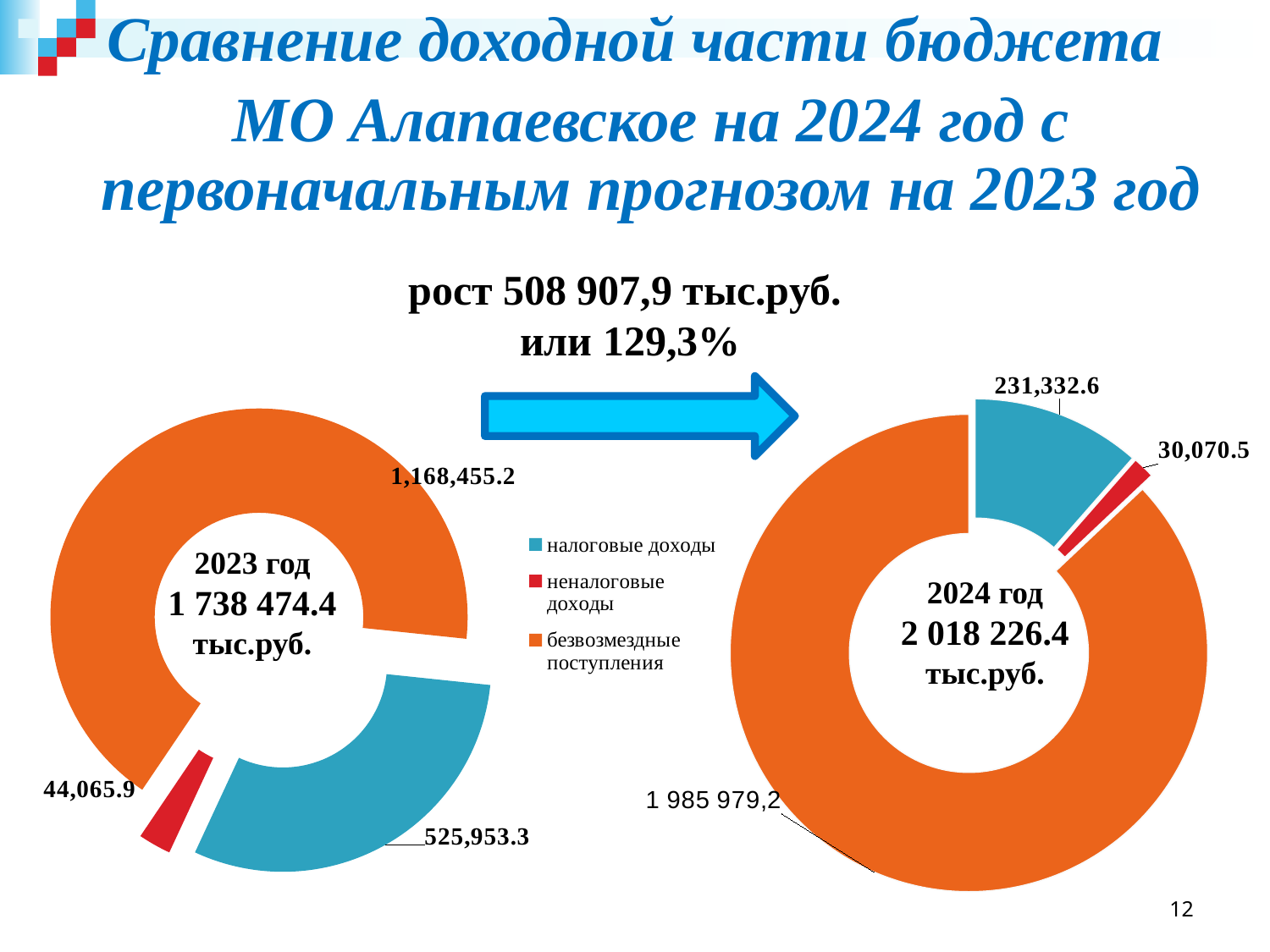
What kind of chart is used on the slide for the 2023 and 2024 budgets? doughnut chart On the left (2023 год) doughnut chart, which category has the largest value? безвозмездные поступления How many series does the legend list? 3 On the right (2024 год) doughnut chart, what is the value for налоговые доходы? 231,332.6 On the left (2023 год) doughnut chart, what is the value for безвозмездные поступления? 1,168,455.2 What total is shown in the centre of the right (2024 год) doughnut chart? 2 018 226.4 тыс.руб. On the right (2024 год) doughnut chart, which category has the smallest value? неналоговые доходы On the left (2023 год) doughnut chart, what is the difference between налоговые доходы and неналоговые доходы? 481,887.4 On the right (2024 год) doughnut chart, what is the value for неналоговые доходы? 30,070.5 On the right (2024 год) doughnut chart, which is larger: налоговые доходы or неналоговые доходы? налоговые доходы On the left (2023 год) doughnut chart, what is the value for налоговые доходы? 525,953.3 On the left (2023 год) doughnut chart, what is the value for неналоговые доходы? 44,065.9